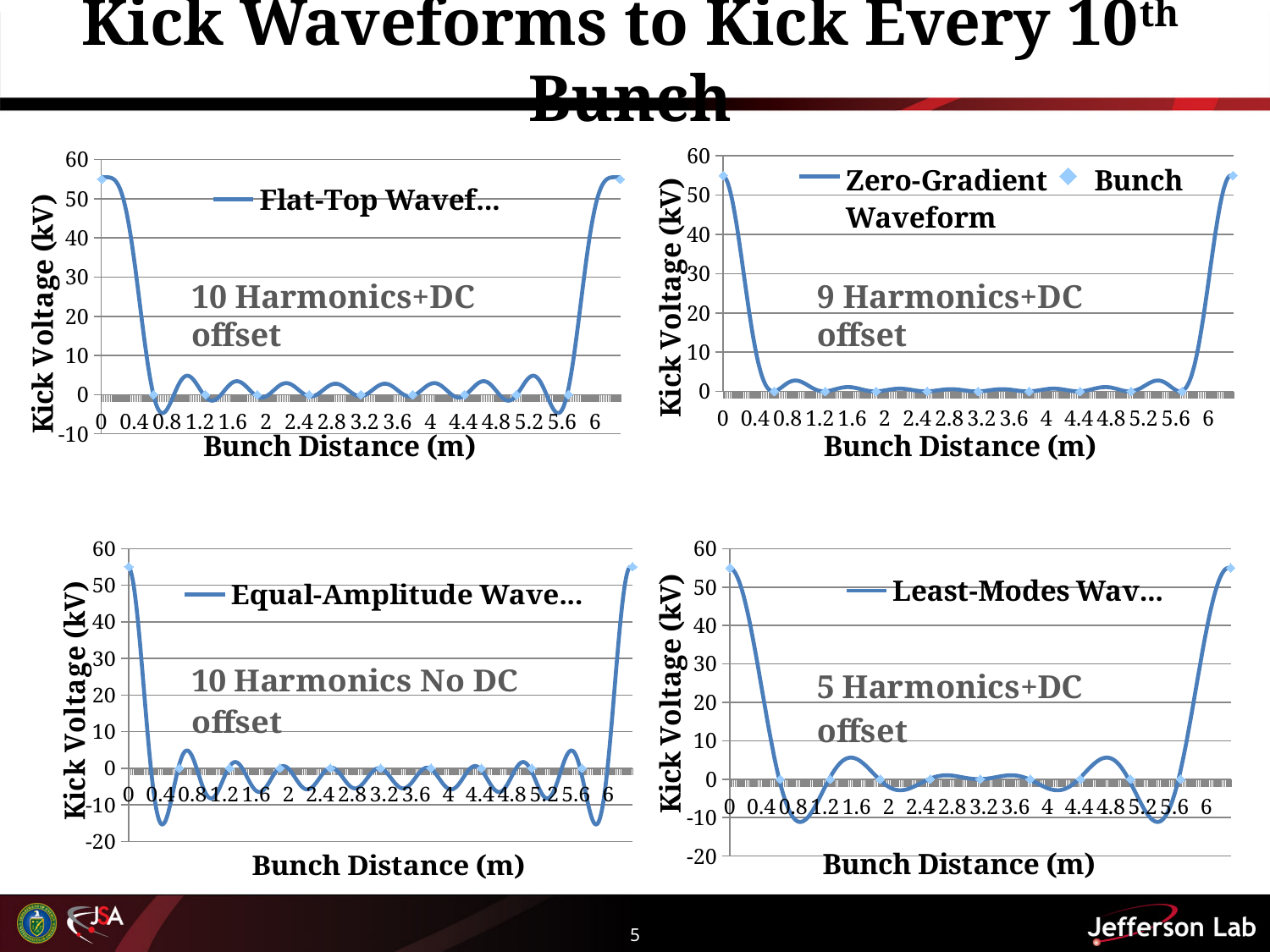
In the top-left chart (Flat-Top Waveform), is the kick voltage at bunch distance 3.2 greater or less than 10? less What kind of chart is the top-left chart (Flat-Top Waveform)? line chart In the bottom-left chart (Equal-Amplitude Waveform), is the lowest point of the waveform greater or less than -10? less In the top-left chart (Flat-Top Waveform), is the kick voltage at bunch distance 0 greater or less than 50? greater What is the y-axis label on the bottom-left chart (Equal-Amplitude Waveform)? Kick Voltage (kV) What is the x-axis label on the top-right chart (Zero-Gradient Waveform)? Bunch Distance (m) In the bottom-right chart (Least-Modes Waveform), does the kick voltage rise or fall between bunch distance 0 and 0.8? fall In the top-right chart, what are the two legend entries? Zero-Gradient Waveform and Bunch In the top-right chart (Zero-Gradient Waveform), does the kick voltage rise or fall between bunch distance 5.6 and 6? rise In the top-right chart, how many series does the legend list? 2